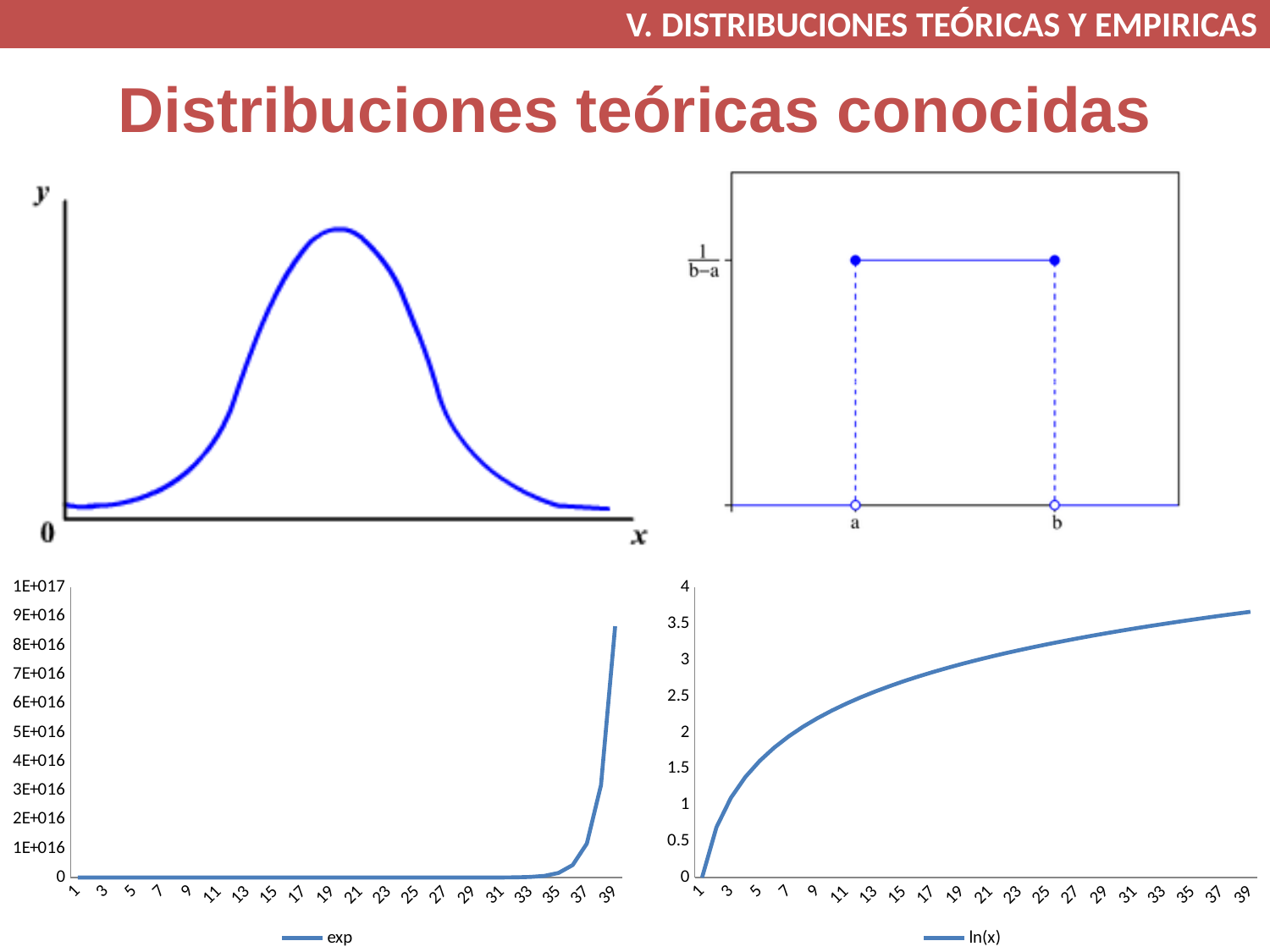
In the bottom-left 'exp' chart, how many series does the legend list? 1 What kind of chart is the bottom-left chart with the legend 'exp'? line chart In the bottom-left 'exp' chart, which is larger: the value at x = 1 or the value at x = 39? x = 39 In the bottom-left 'exp' chart, is the value at x = 39 greater or less than 8E+016? greater What kind of chart is the bottom-right chart with the legend 'ln(x)'? line chart In the bottom-left 'exp' chart, is the value at x = 35 greater or less than 1E+016? less In the bottom-right 'ln(x)' chart, is the value at x = 11 greater or less than 2? greater In the bottom-right 'ln(x)' chart, do the values rise or fall as x increases? rise In the bottom-left 'exp' chart, do the values rise or fall as x increases? rise In the bottom-right 'ln(x)' chart, how many series does the legend list? 1 What is the name of the series shown in the legend of the bottom-right chart? ln(x)